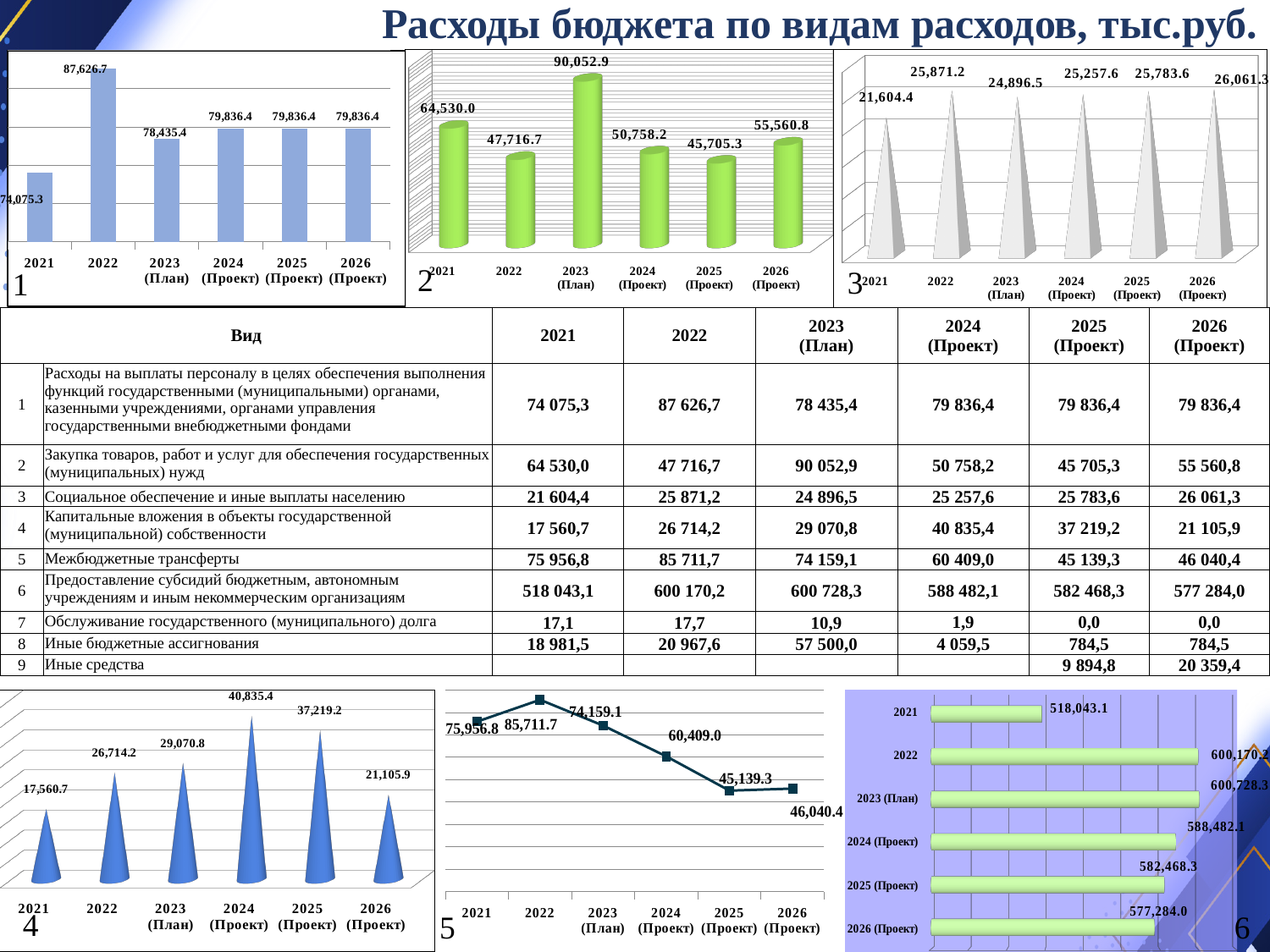
In chart 5 (bottom-middle), do the values rise or fall from 2022 to 2025 (Проект)? Fall How many years are shown on the x axis of chart 1 (top-left)? 6 In chart 4 (bottom-left), what is the difference between the values for 2024 (Проект) and 2025 (Проект)? 3,616.2 In chart 1 (top-left), what is the value for 2022? 87,626.7 In chart 2 (top-middle), what is the difference between the values for 2023 (План) and 2022? 42,336.2 What kind of chart is chart 5 (bottom-middle)? Line chart In chart 2 (top-middle), which year has the highest value? 2023 (План) In chart 6 (bottom-right), what is the value for 2021? 518,043.1 In chart 4 (bottom-left), which is larger, the value for 2021 or for 2026 (Проект)? 2026 (Проект) In chart 2 (top-middle), which year has the lowest value? 2025 (Проект) In chart 3 (top-right), what is the value for 2026 (Проект)? 26,061.3 In chart 6 (bottom-right), which year has the lowest value? 2021